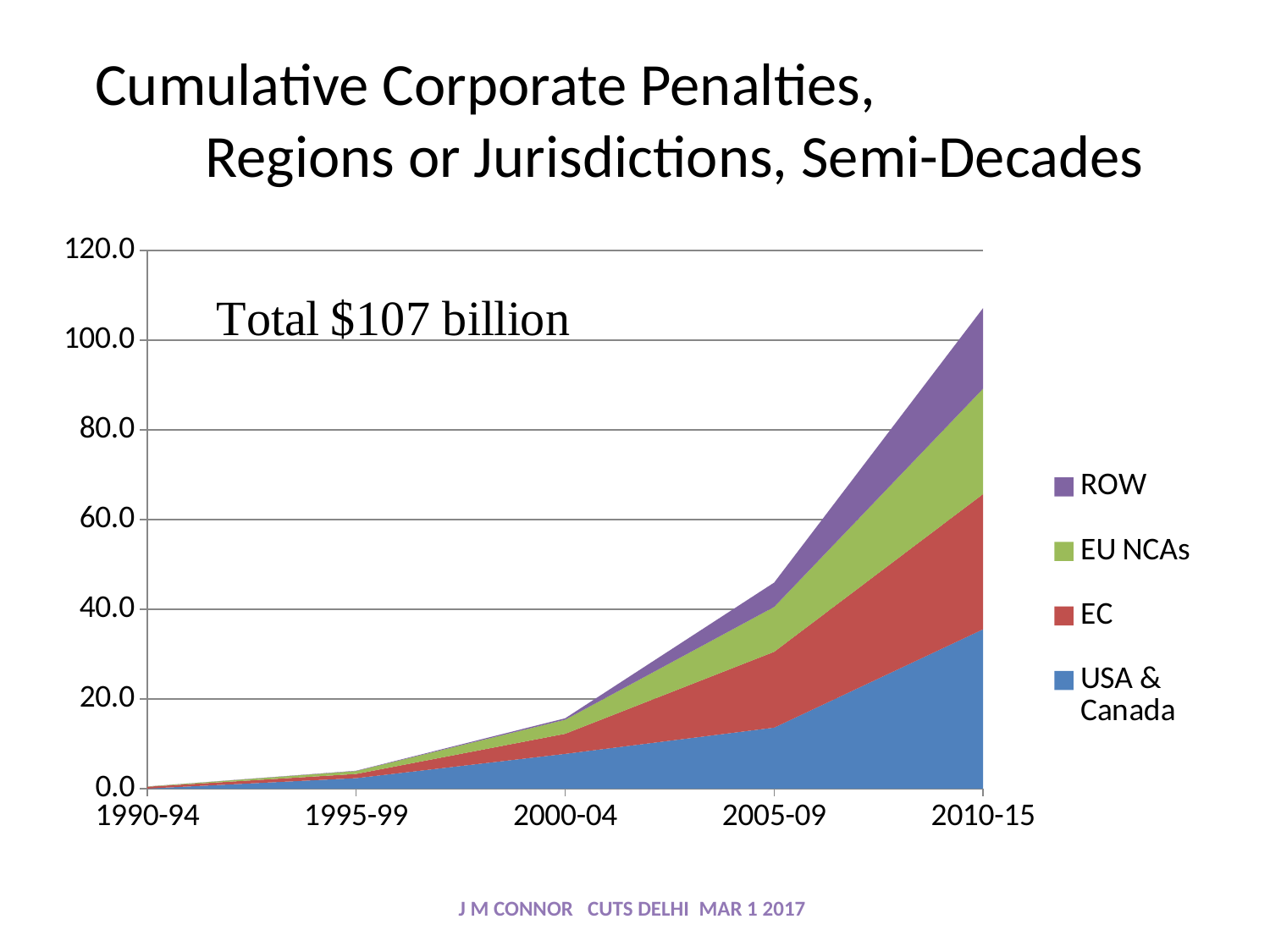
What kind of chart is shown on the slide? Stacked area chart How many series does the legend list? 4 Is the total value for 2010-15 greater or less than 100? greater Is the total value for 2000-04 greater or less than 20? less Which series is plotted at the bottom of the stack? USA & Canada What colour represents the ROW series? Purple How many semi-decade periods are shown on the x axis? 5 Is the total value for 2005-09 greater or less than 40? greater Which period has the lowest total cumulative penalties? 1990-94 What total amount is stated in the annotation on the chart? Total $107 billion Do the cumulative penalties rise or fall across the periods from 1990-94 to 2010-15? Rise Which period has the highest total cumulative penalties? 2010-15